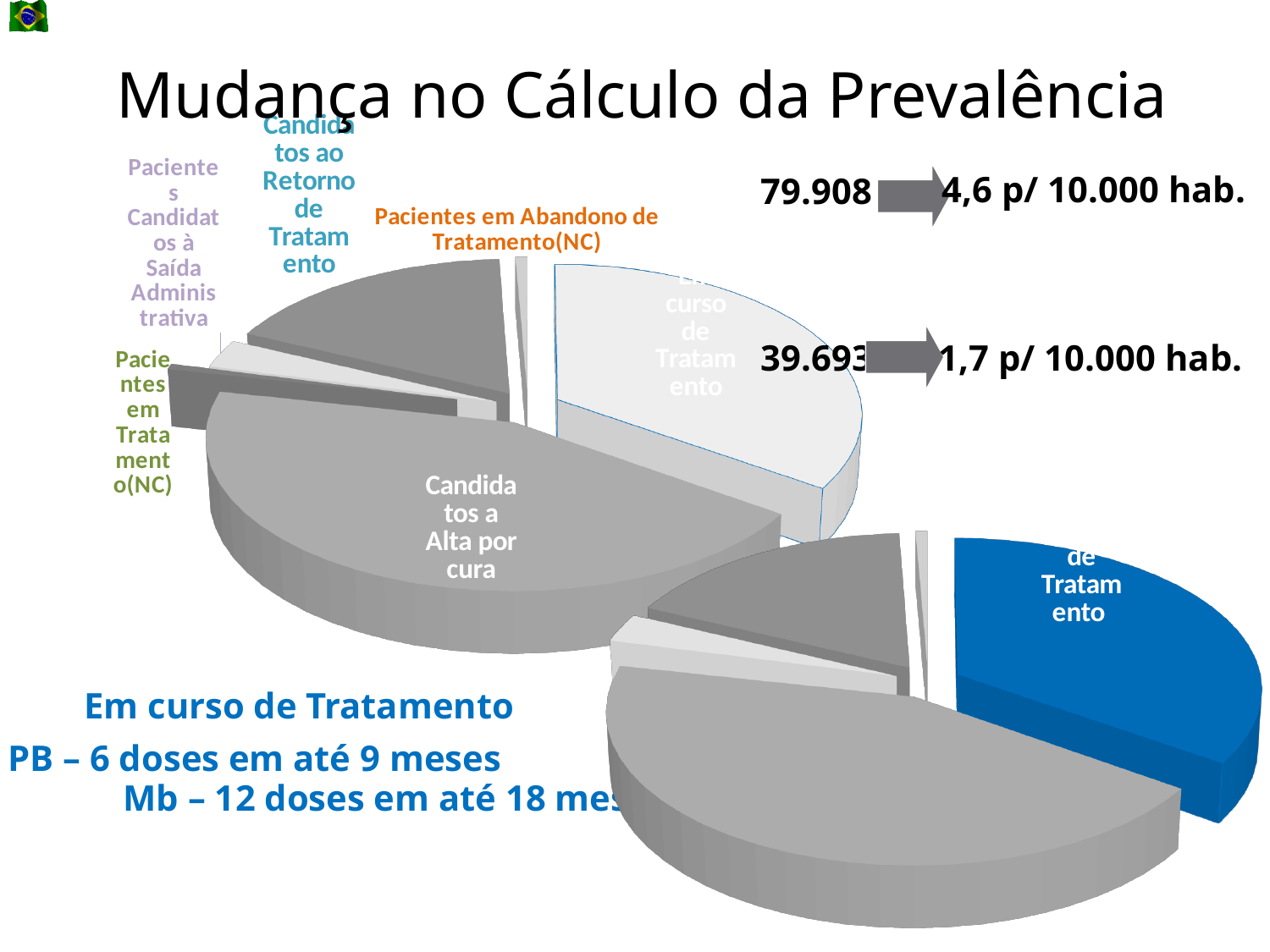
In the upper pie chart, which slice is larger: Candidatos ao Retorno de Tratamento or Pacientes em Abandono de Tratamento(NC)? Candidatos ao Retorno de Tratamento In the lower pie chart, which category is shown in blue? Em curso de Tratamento In the upper pie chart, which slice is larger: Em curso de Tratamento or Pacientes em Tratamento(NC)? Em curso de Tratamento What is the title of the slide containing the pie charts? Mudança no Cálculo da Prevalência In the upper pie chart, which category has the largest slice? Candidatos a Alta por cura What kind of chart is shown on the slide? Pie chart In the upper pie chart, which slice is larger: Candidatos a Alta por cura or Em curso de Tratamento? Candidatos a Alta por cura How many pie charts are on the slide? 2